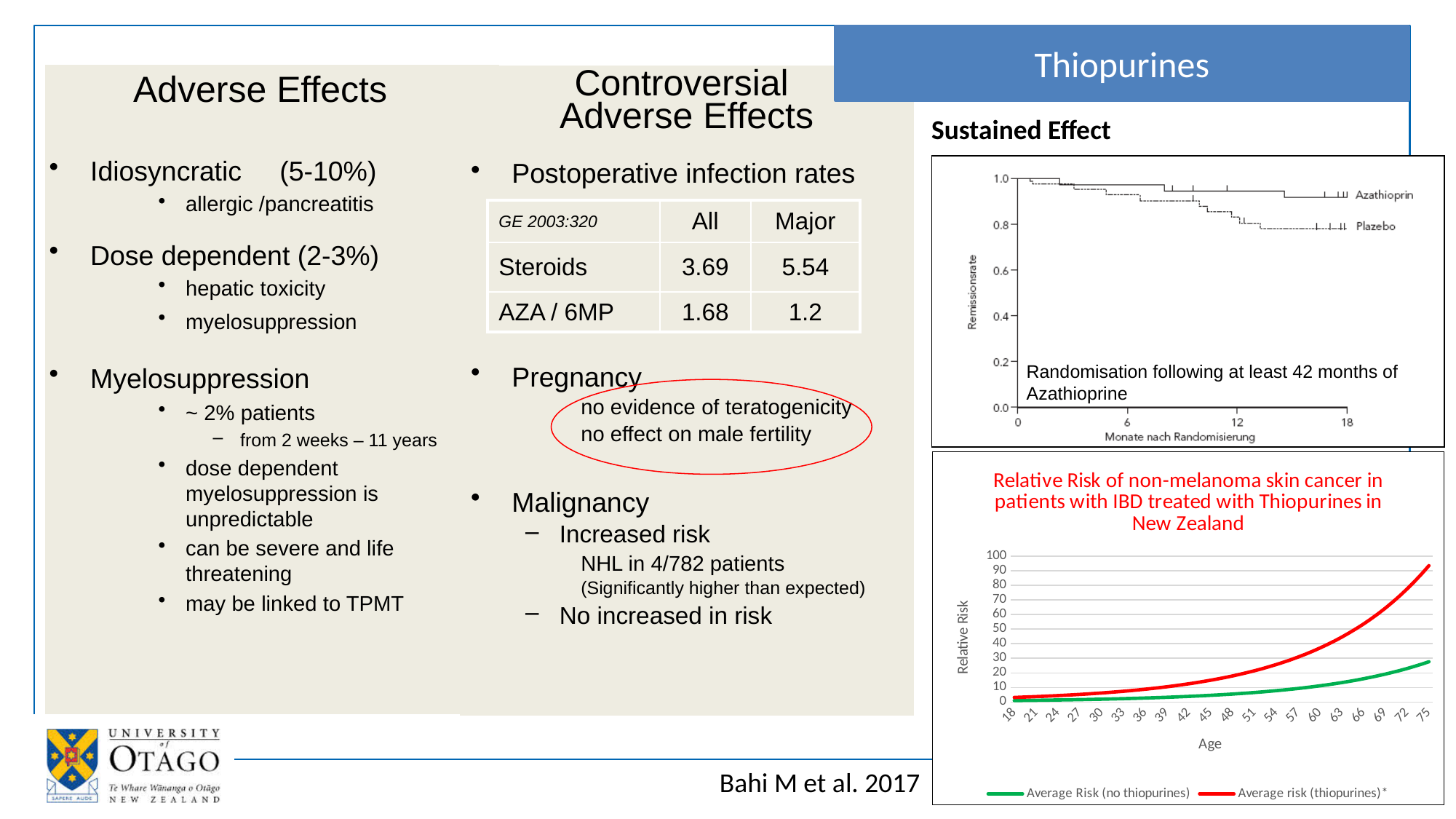
In the 'Relative Risk of non-melanoma skin cancer' chart, does the relative risk rise or fall as age increases? rise In the 'Sustained Effect' chart, is the remission rate for Azathioprin at 18 months greater or less than 0.8? greater What kind of chart is the 'Relative Risk of non-melanoma skin cancer' chart at the bottom right? line chart In the 'Sustained Effect' chart, which series has the higher remission rate at 18 months, Azathioprin or Plazebo? Azathioprin In the 'Relative Risk of non-melanoma skin cancer' chart, which series is higher at age 75, 'Average risk (thiopurines)*' or 'Average Risk (no thiopurines)'? Average risk (thiopurines)* In the 'Relative Risk of non-melanoma skin cancer' chart, how many series does the legend list? 2 In the 'Relative Risk of non-melanoma skin cancer' chart, is the value for 'Average Risk (no thiopurines)' at age 75 greater or less than 40? less In the 'Relative Risk of non-melanoma skin cancer' chart, is the value for 'Average risk (thiopurines)*' at age 75 greater or less than 80? greater In the 'Relative Risk of non-melanoma skin cancer' chart, what is the label of the red series in the legend? Average risk (thiopurines)* In the 'Relative Risk of non-melanoma skin cancer' chart, how many age ticks are shown on the x axis? 20 In the 'Sustained Effect' chart, how many series are plotted? 2 In the 'Relative Risk of non-melanoma skin cancer' chart, what is the label of the green series in the legend? Average Risk (no thiopurines)